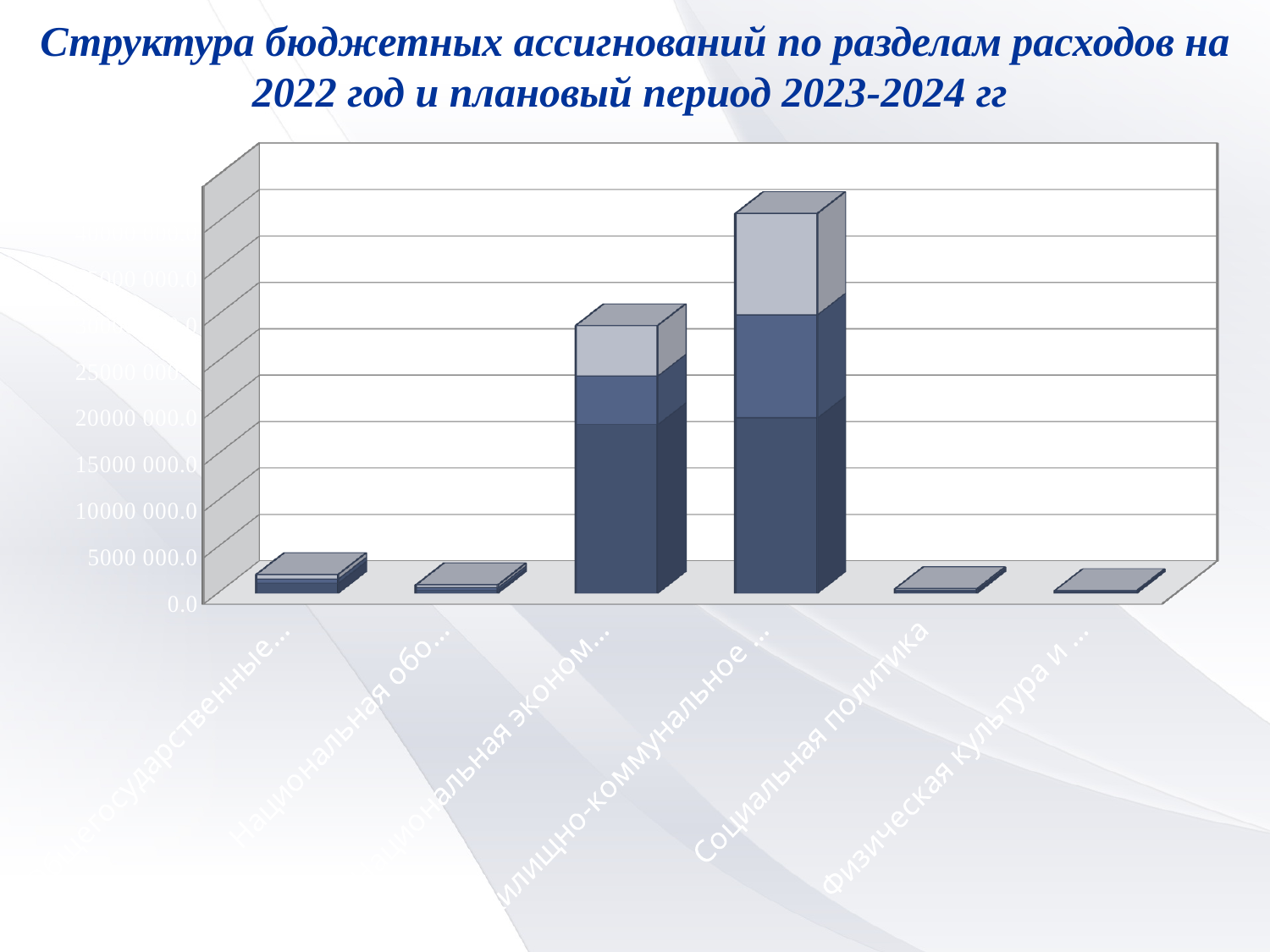
Is the total value of the "Общегосударственные..." bar greater or less than 5000 000.0? less Which bar is taller: "Жилищно-коммунальное ..." or "Национальная эконом..."? Жилищно-коммунальное ... How many stacked segments make up the "Жилищно-коммунальное ..." bar? 3 What kind of chart is shown on the slide? Stacked bar chart How many categories are plotted along the x axis of the chart? 6 What is the title of the chart on the slide? Структура бюджетных ассигнований по разделам расходов на 2022 год и плановый период 2023-2024 гг Which category has the tallest bar in the chart? Жилищно-коммунальное ... Which bar is taller: "Общегосударственные..." or "Национальная эконом..."? Национальная эконом... What is the lowest tick value shown on the vertical axis of the chart? 0.0 Is the total value of the "Национальная эконом..." bar greater or less than 20000 000.0? greater Is the total value of the "Жилищно-коммунальное ..." bar greater or less than 25000 000.0? greater